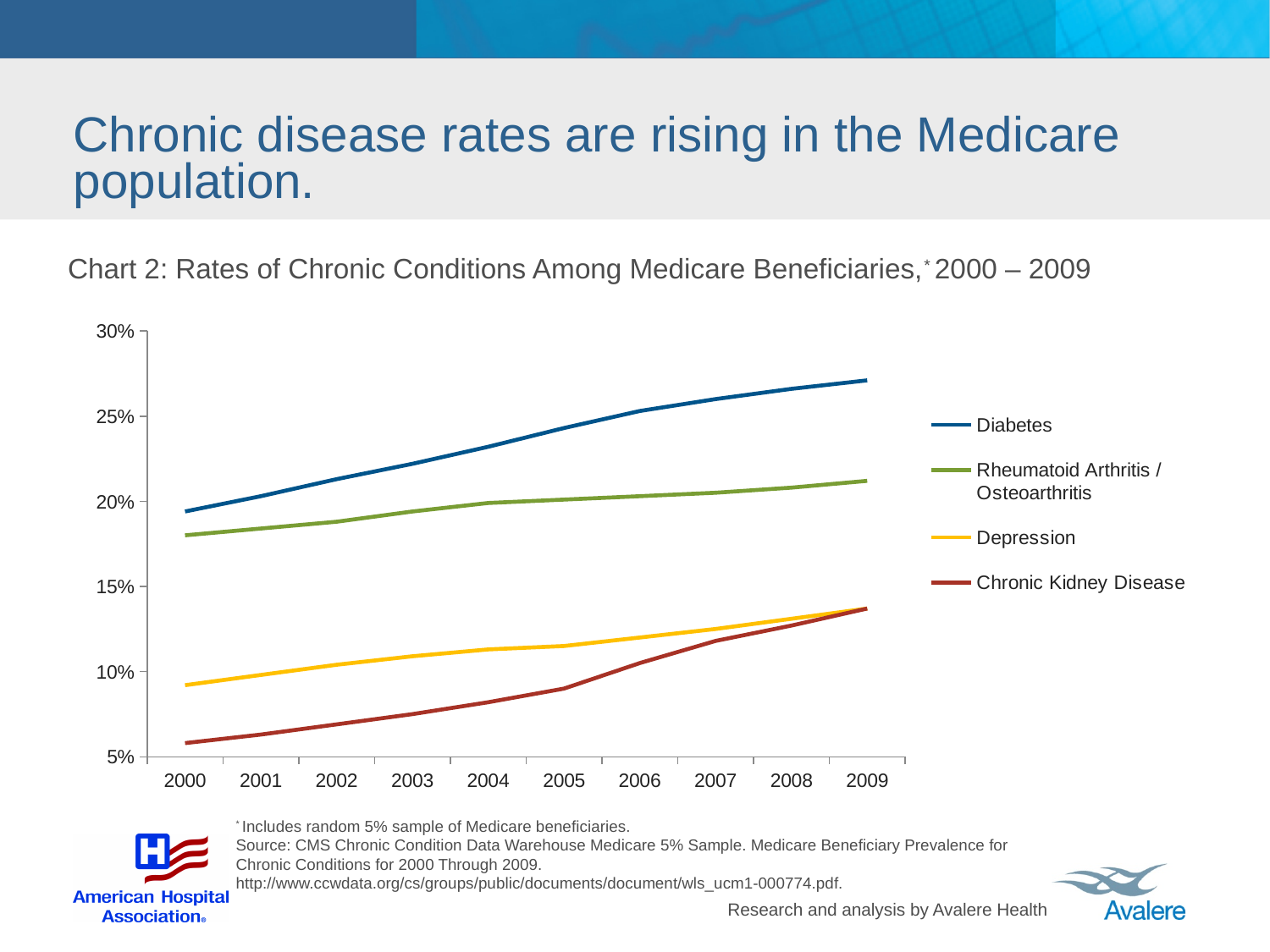
Which condition has the lowest rate in 2000? Chronic Kidney Disease How many years are shown along the x axis? 10 In 2005, which is larger: the Depression rate or the Chronic Kidney Disease rate? Depression In 2009, which is larger: the Diabetes rate or the Depression rate? Diabetes Is the Chronic Kidney Disease rate in 2000 greater or less than 10%? less What colour is the line for Depression? yellow Does the Diabetes rate rise or fall from 2000 to 2009? rise Is the Diabetes rate in 2009 greater or less than 25%? greater Is the Rheumatoid Arthritis / Osteoarthritis rate in 2009 greater or less than 20%? greater How many series does the legend list? 4 What kind of chart is shown on the slide? line chart Which condition has the highest rate in 2009? Diabetes